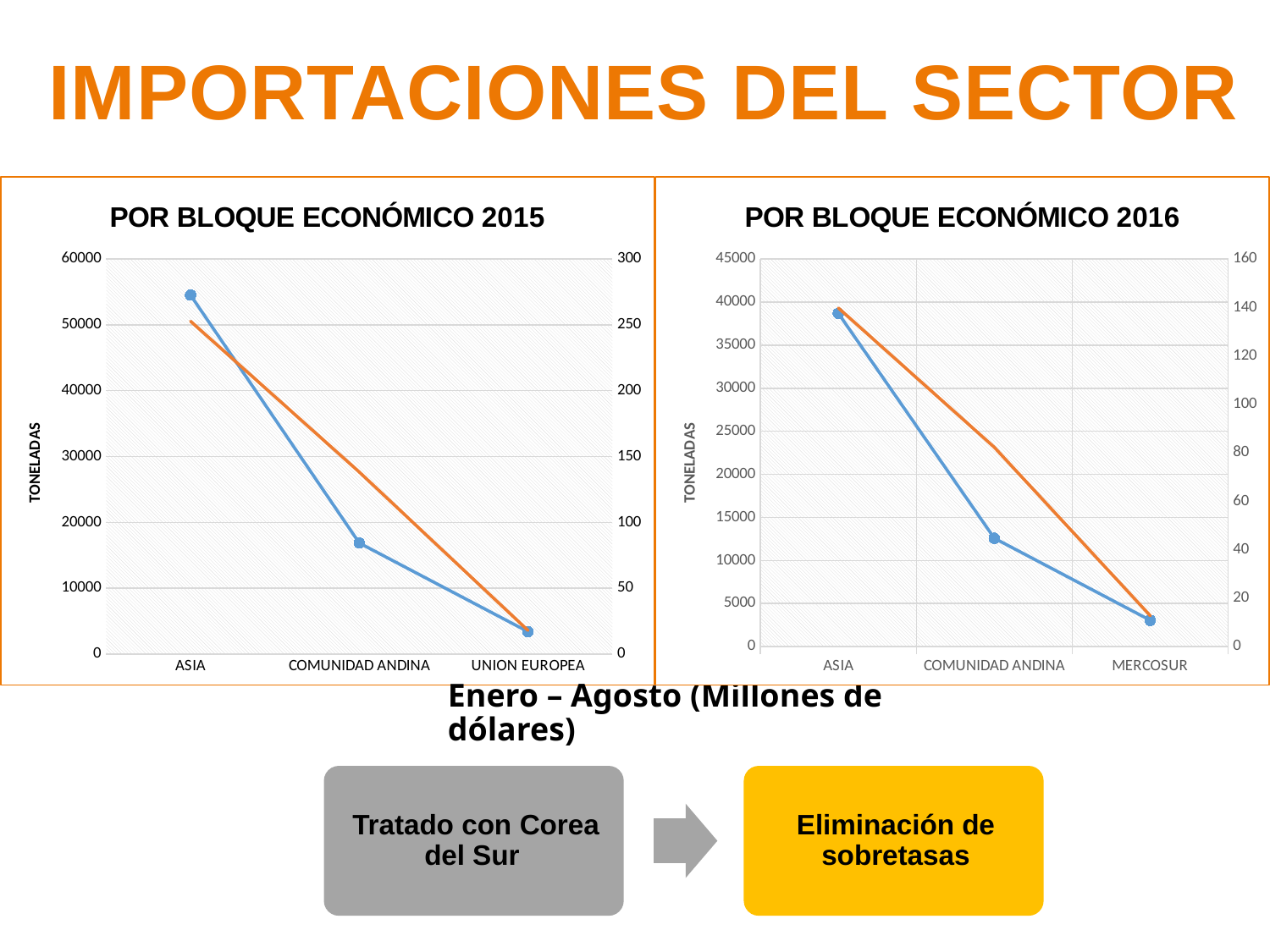
How many categories are shown on the x axis of the 'POR BLOQUE ECONÓMICO 2016' chart? 3 In the 'POR BLOQUE ECONÓMICO 2016' chart, is the blue-line value for ASIA greater or less than 40000? less What is the label on the left vertical axis of the 'POR BLOQUE ECONÓMICO 2016' chart? TONELADAS What kind of chart is the 'POR BLOQUE ECONÓMICO 2015' chart? line chart In the 'POR BLOQUE ECONÓMICO 2015' chart, is the blue-line value for COMUNIDAD ANDINA greater or less than 20000? less In the 'POR BLOQUE ECONÓMICO 2016' chart, is the blue-line value for COMUNIDAD ANDINA greater or less than 15000? less In the 'POR BLOQUE ECONÓMICO 2016' chart, which category has the lowest value on the blue line? MERCOSUR In the 'POR BLOQUE ECONÓMICO 2015' chart, which category has the highest value on the blue line? ASIA In the 'POR BLOQUE ECONÓMICO 2016' chart, do the values rise or fall from ASIA to MERCOSUR? fall In the 'POR BLOQUE ECONÓMICO 2015' chart, which is larger on the blue line: COMUNIDAD ANDINA or UNION EUROPEA? COMUNIDAD ANDINA In the 'POR BLOQUE ECONÓMICO 2015' chart, which category has the lowest value on the blue line? UNION EUROPEA